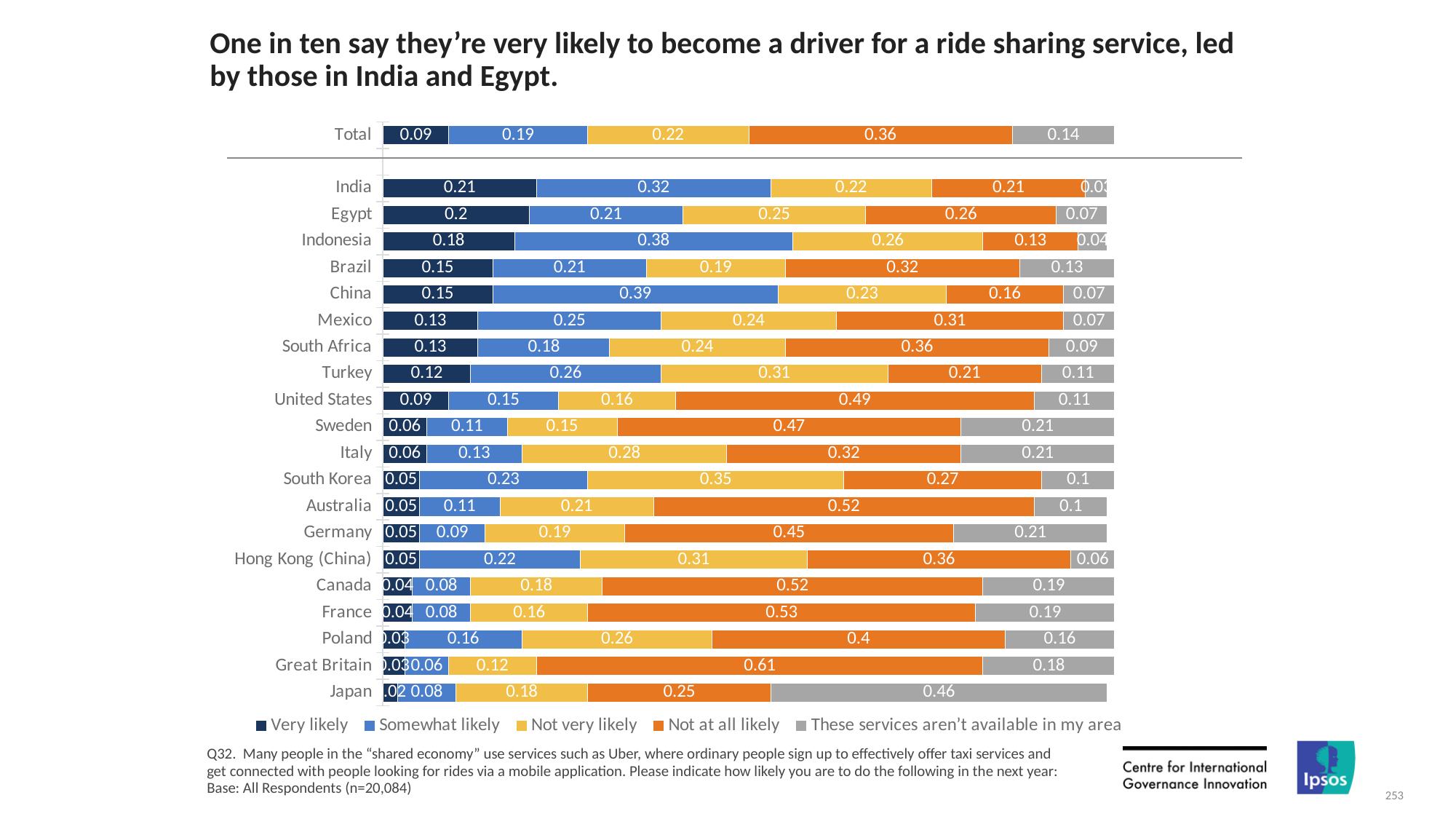
What is the 'These services aren't available in my area' value for Japan? 0.46 What is the 'Very likely' value for India? 0.21 What is the 'Not at all likely' value for Great Britain? 0.61 What is the difference between the 'Not at all likely' values for Great Britain and Japan? 0.36 How many series does the legend list? 5 What kind of chart is shown on the slide? Stacked bar chart Which is larger, the 'Somewhat likely' value for China or for Indonesia? China What is the 'Somewhat likely' value for the Total row? 0.19 Which country has the lowest 'Very likely' value? Japan How many countries are shown in the chart, excluding the Total row? 20 Which country has the highest 'Not at all likely' value? Great Britain Which country has the highest 'Very likely' value? India